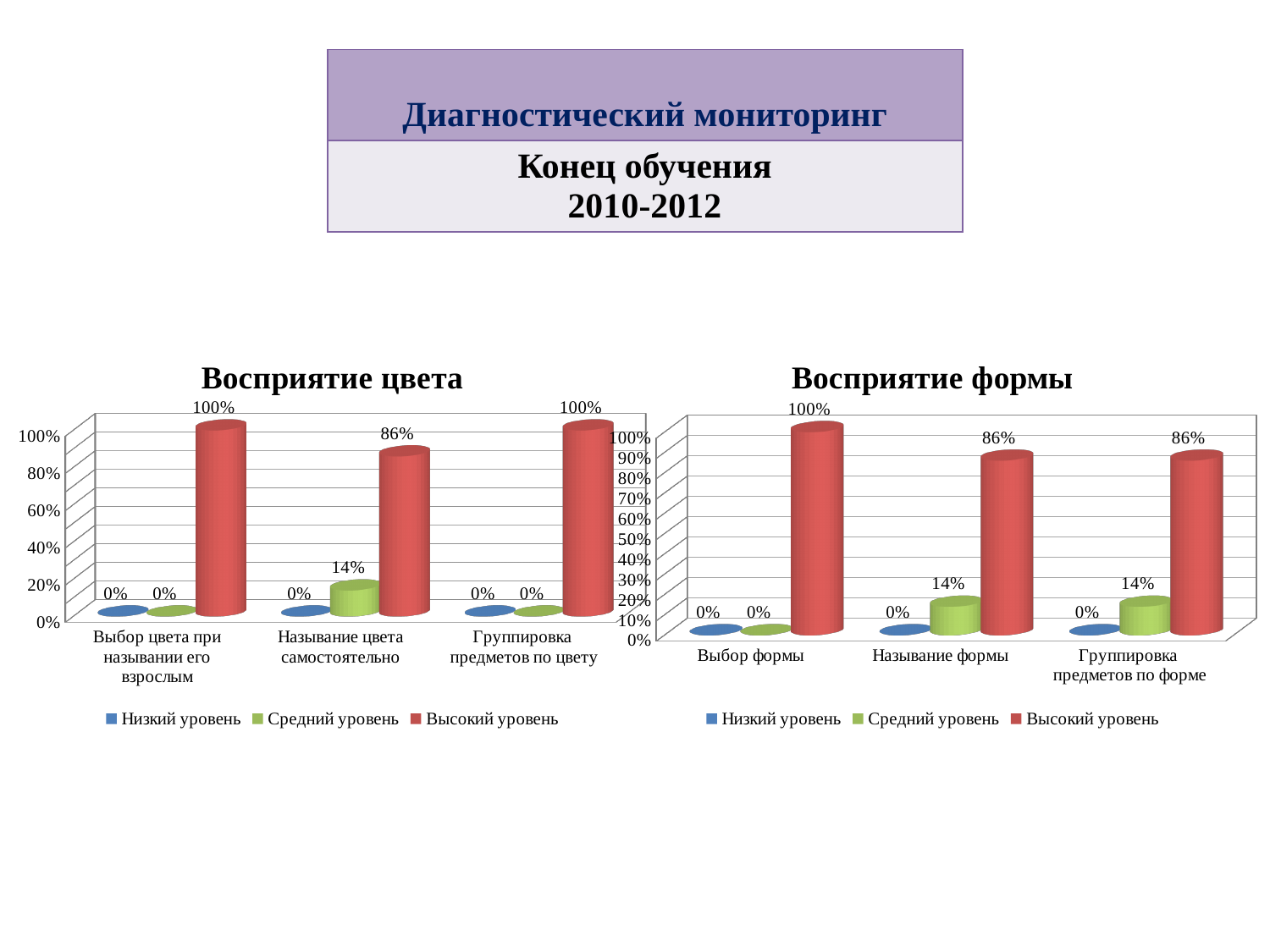
How many categories are shown on the x axis of the chart titled "Восприятие формы"? 3 In the chart titled "Восприятие формы", which is larger: "Высокий уровень" for "Выбор формы" or "Высокий уровень" for "Называние формы"? Выбор формы In the chart titled "Восприятие цвета", which category has the lowest value for "Высокий уровень"? Называние цвета самостоятельно In the chart titled "Восприятие формы", what is the value of "Средний уровень" for "Группировка предметов по форме"? 14% In the chart titled "Восприятие цвета", what is the value of "Высокий уровень" for "Называние цвета самостоятельно"? 86% In the chart titled "Восприятие формы", what colour represents "Высокий уровень"? Red In the chart titled "Восприятие цвета", what is the difference between the "Высокий уровень" values for "Выбор цвета при назывании его взрослым" and "Называние цвета самостоятельно"? 14% What kind of chart is the chart titled "Восприятие цвета"? Bar chart How many series does the legend of the chart titled "Восприятие цвета" list? 3 In the chart titled "Восприятие формы", what is the value of "Высокий уровень" for "Выбор формы"? 100% In the chart titled "Восприятие цвета", what is the value of "Средний уровень" for "Называние цвета самостоятельно"? 14% In the chart titled "Восприятие формы", which category has the highest value for "Высокий уровень"? Выбор формы